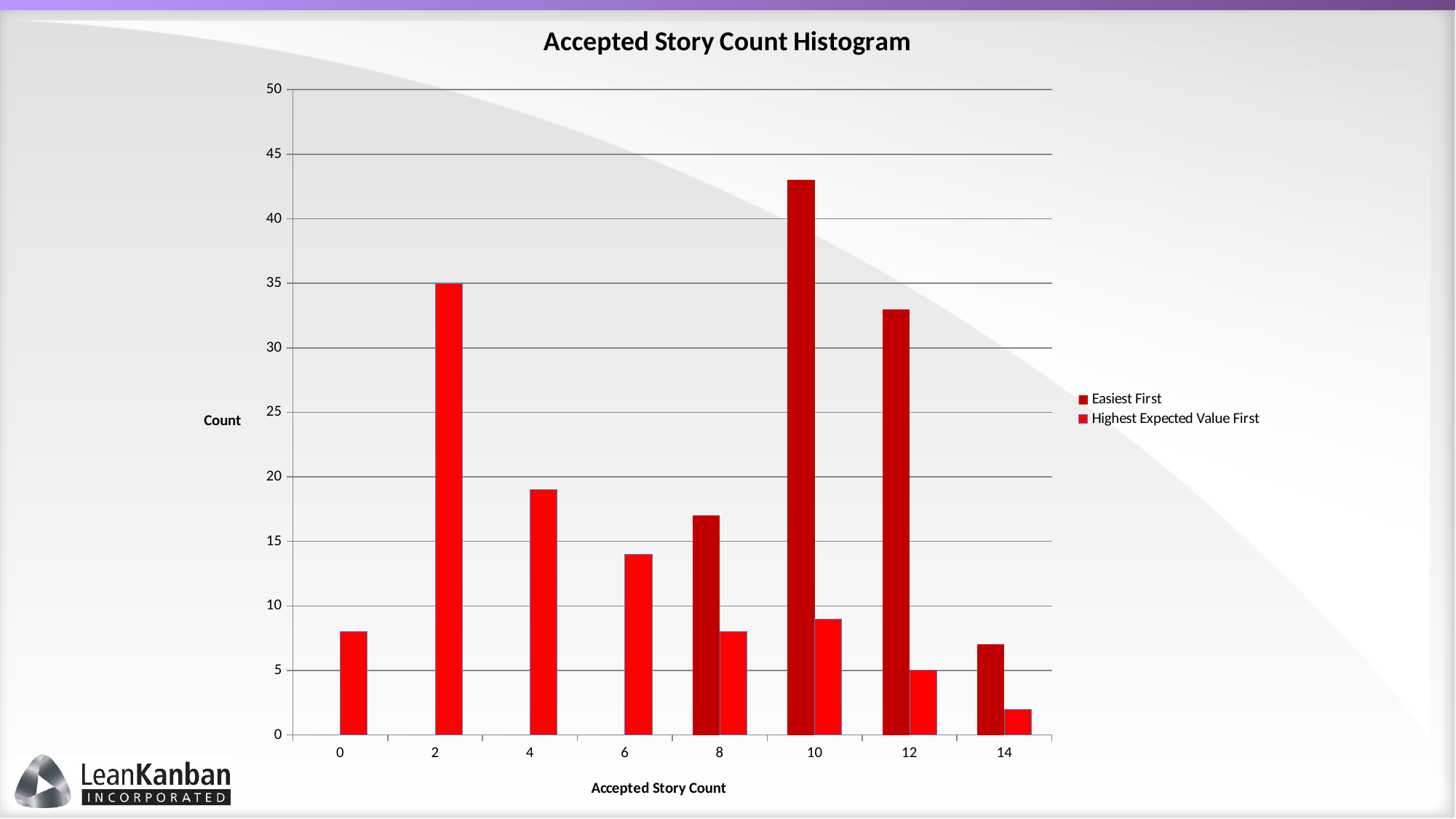
How many series does the legend list? 2 Is the Easiest First value at Accepted Story Count 10 greater or less than 40? greater What kind of chart is shown on the slide? bar chart At which Accepted Story Count is the Easiest First series highest? 10 At which Accepted Story Count is the Highest Expected Value First series highest? 2 At which Accepted Story Count is the Highest Expected Value First series lowest? 14 Is the Highest Expected Value First value at Accepted Story Count 4 greater or less than 20? less At Accepted Story Count 8, which series has the larger value, Easiest First or Highest Expected Value First? Easiest First Is the Highest Expected Value First value at Accepted Story Count 0 greater or less than 10? less What are the two series named in the legend? Easiest First and Highest Expected Value First At Accepted Story Count 12, which series has the larger value, Easiest First or Highest Expected Value First? Easiest First What is the title of the vertical axis? Count